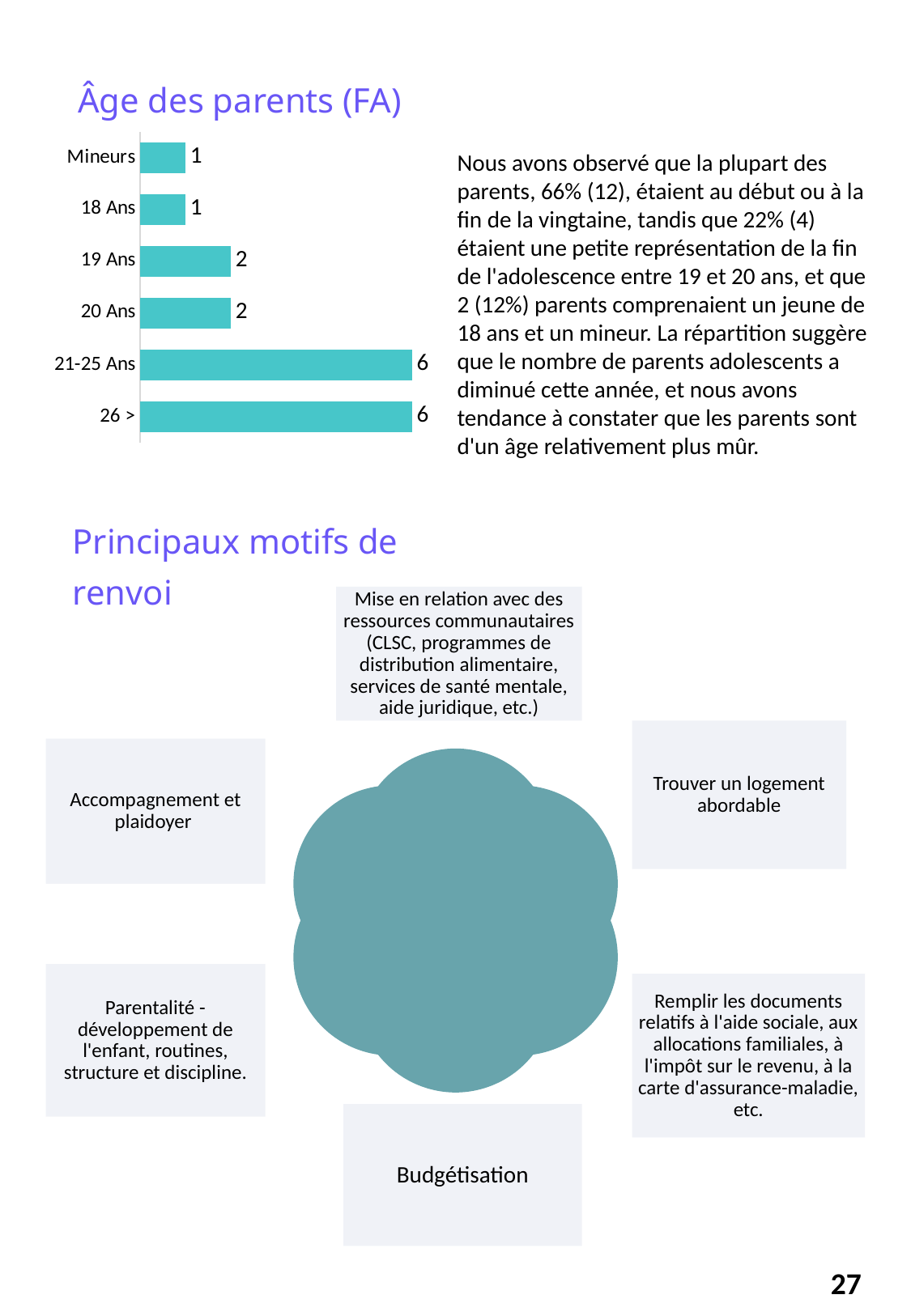
In the "Âge des parents (FA)" chart, what is the value for 18 Ans? 1 In the "Âge des parents (FA)" chart, what is the value for Mineurs? 1 In the "Âge des parents (FA)" chart, what is the difference between the values for 21-25 Ans and 20 Ans? 4 In the "Âge des parents (FA)" chart, what is the value for 26 >? 6 What kind of chart is "Âge des parents (FA)"? bar chart What is the title of the bar chart on the slide? Âge des parents (FA) In the "Âge des parents (FA)" chart, which two categories share the highest value? 21-25 Ans and 26 > How many categories are shown in the "Âge des parents (FA)" chart? 6 In the "Âge des parents (FA)" chart, what is the difference between the values for 20 Ans and 18 Ans? 1 In the "Âge des parents (FA)" chart, what is the value for 19 Ans? 2 In the "Âge des parents (FA)" chart, which is larger, the value for 19 Ans or the value for Mineurs? 19 Ans In the "Âge des parents (FA)" chart, what is the value for 21-25 Ans? 6